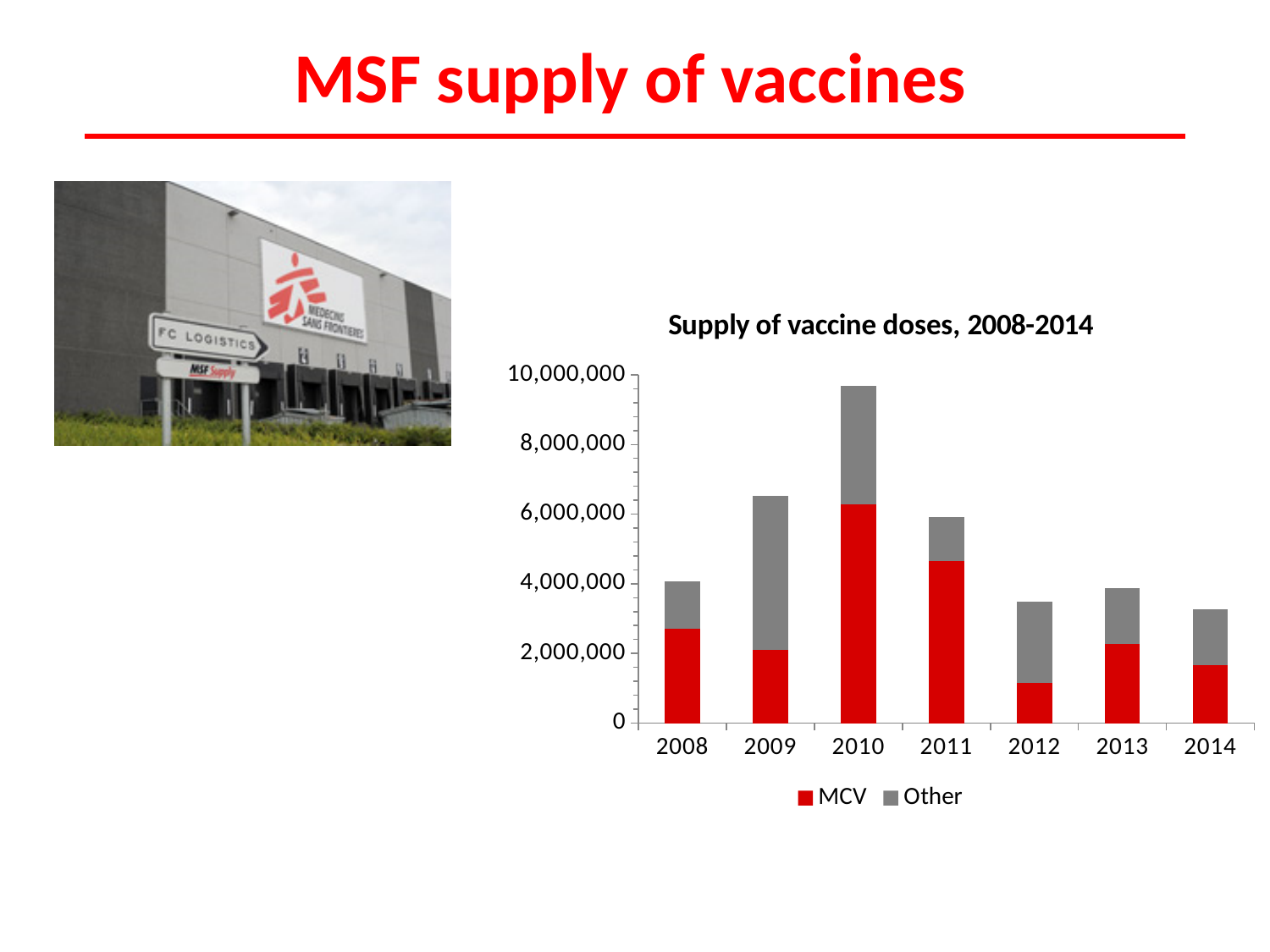
How many series does the legend list? 2 What is the title of the chart? Supply of vaccine doses, 2008-2014 Is the MCV supply in 2012 greater or less than 2,000,000? less Which year has the highest total supply of vaccine doses? 2010 Do the total supplies of vaccine doses rise or fall from 2010 to 2012? fall Is the total supply of vaccine doses in 2010 greater or less than 8,000,000? greater What kind of chart is shown on the slide? bar chart Which year has the highest MCV supply? 2010 How many years are shown on the x axis? 7 Which year has the larger MCV supply, 2008 or 2009? 2008 Is the MCV supply in 2011 greater or less than 4,000,000? greater Which year has the lowest MCV supply? 2012